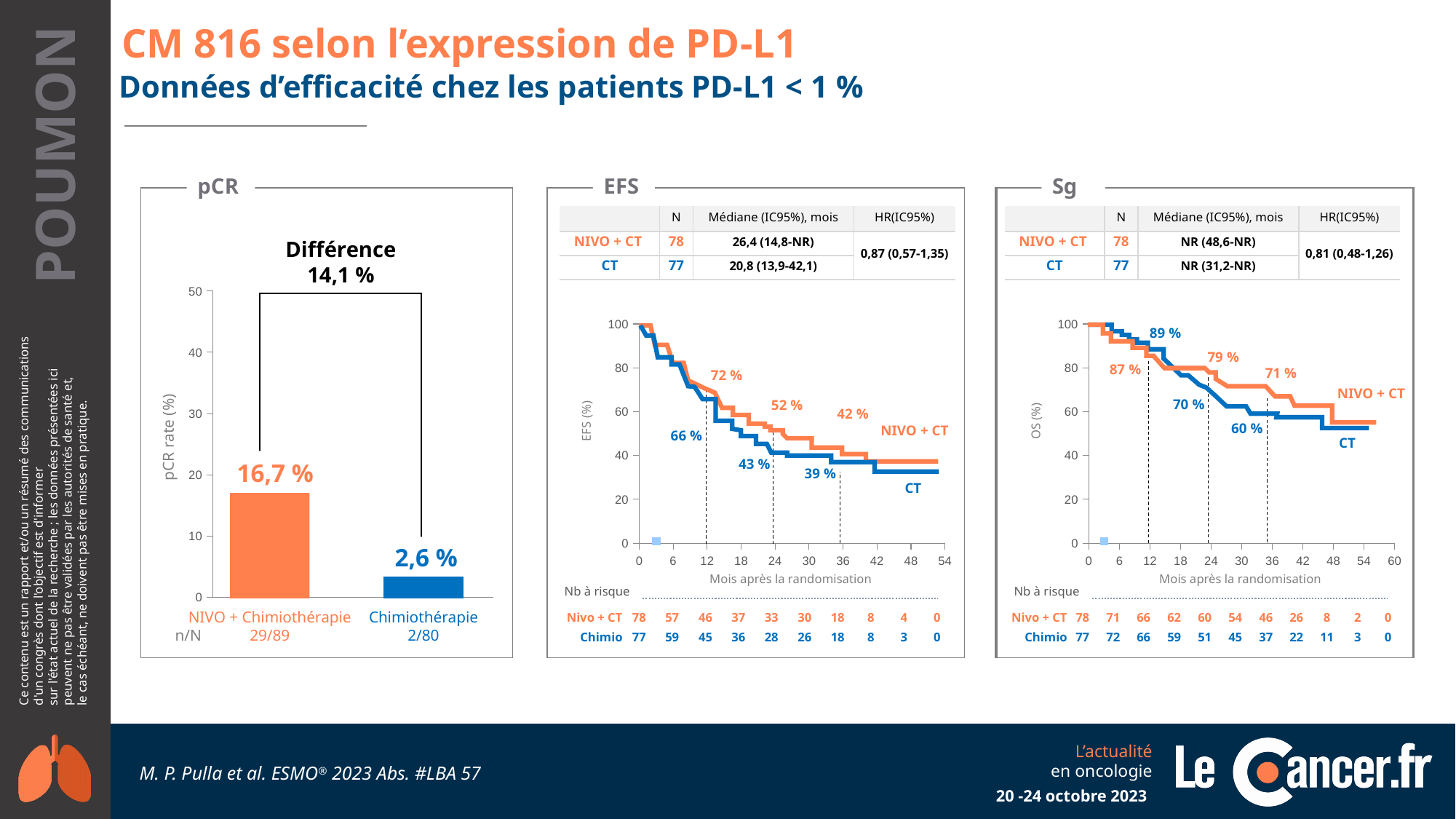
In the pCR chart, which arm has the higher pCR rate? NIVO + Chimiothérapie What kind of chart is the pCR chart? bar chart How many curves (series) are plotted in the EFS chart? 2 In the Sg chart, what is the difference between the NIVO + CT and CT OS rates at 36 months? 11 % In the pCR chart, what is the difference in pCR rate between NIVO + Chimiothérapie and Chimiothérapie? 14,1 % In the EFS chart, what is the EFS rate for CT at 24 months? 43 % In the EFS chart, what is the EFS rate for NIVO + CT at 12 months? 72 % In the Sg chart, what is the OS rate for NIVO + CT at 36 months? 71 % In the pCR chart, what is the pCR rate for NIVO + Chimiothérapie? 16,7 % In the pCR chart, what is the pCR rate for Chimiothérapie? 2,6 % In the EFS chart, do the curves rise or fall over the months after randomisation? fall In the Sg chart, what is the OS rate for CT at 24 months? 70 %